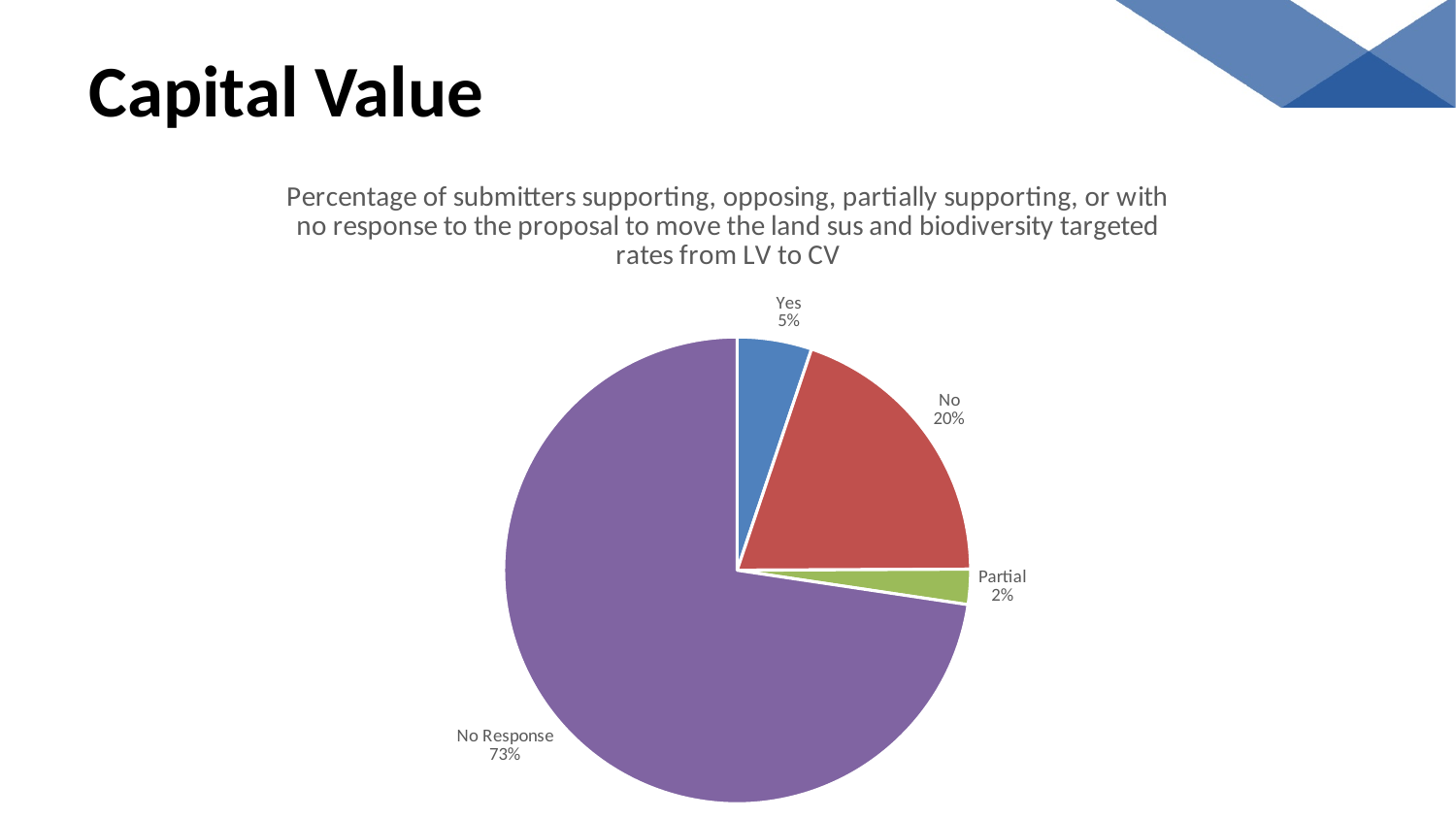
Which category has the smallest share of the pie? Partial Which is larger, the share for No or the share for Yes? No What percentage of submitters partially supported the proposal? 2% How many slices does the pie chart have? 4 What is the difference in percentage points between No and Yes? 15 What colour is the No Response slice? purple What percentage of submitters answered No? 20% Which category has the largest share of the pie? No Response What kind of chart is shown on the slide? pie chart What percentage of submitters answered Yes? 5% What percentage of submitters had no response? 73% What is the difference in percentage points between No Response and No? 53